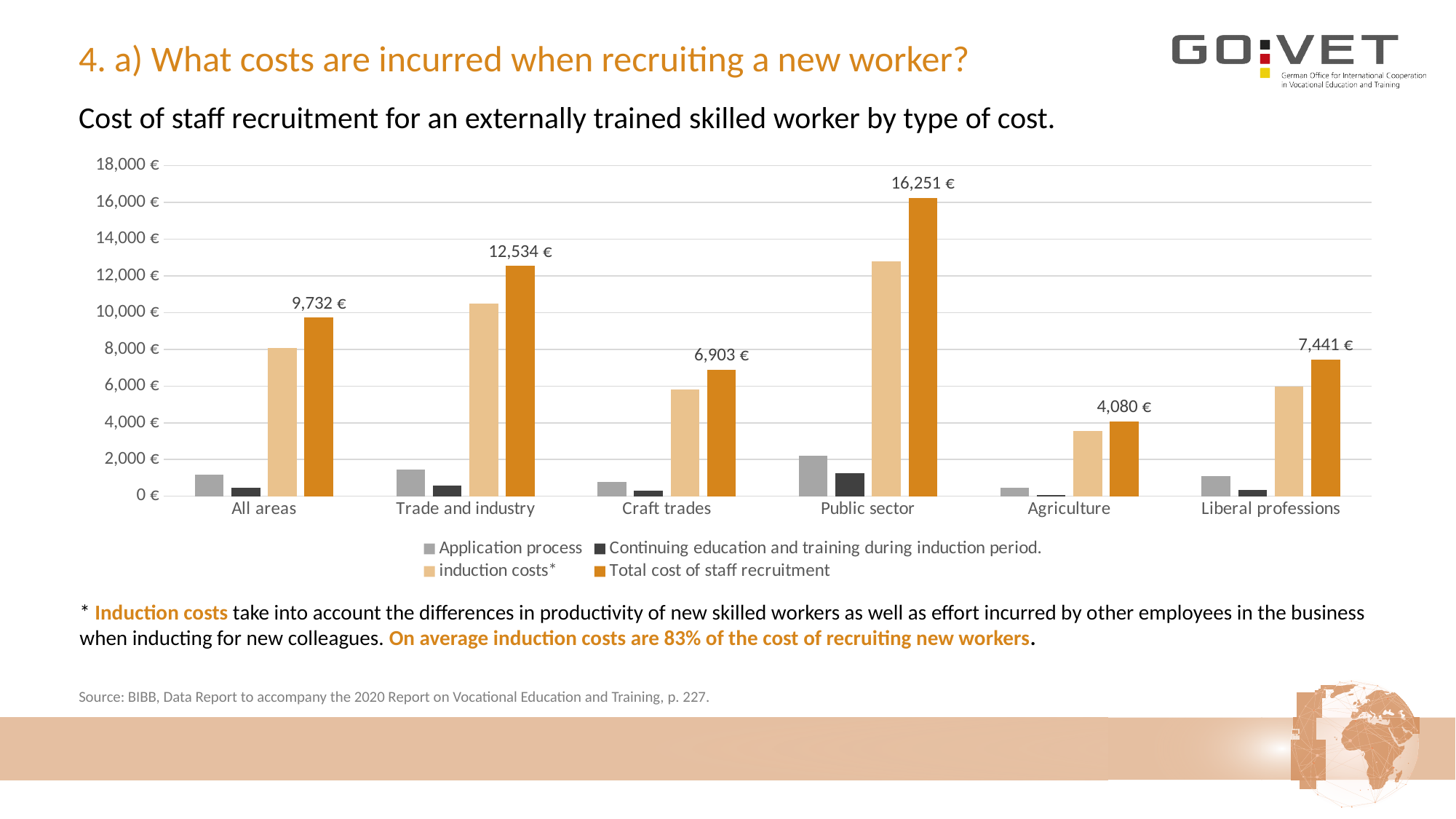
What is the difference between the total cost of staff recruitment for Public sector and for Craft trades? 9,348 € Which category has the highest total cost of staff recruitment? Public sector What is the total cost of staff recruitment for the Public sector? 16,251 € Which category has the lowest total cost of staff recruitment? Agriculture How many categories are shown on the x axis? 6 Is the Application process value for Trade and industry greater or less than 2,000 €? less Is the induction costs value for Public sector greater or less than 12,000 €? greater What kind of chart is shown on the slide? Bar chart What is the total cost of staff recruitment for Agriculture? 4,080 € Which has a larger total cost of staff recruitment, Liberal professions or Craft trades? Liberal professions What is the total cost of staff recruitment for Trade and industry? 12,534 € How many series does the legend list? 4